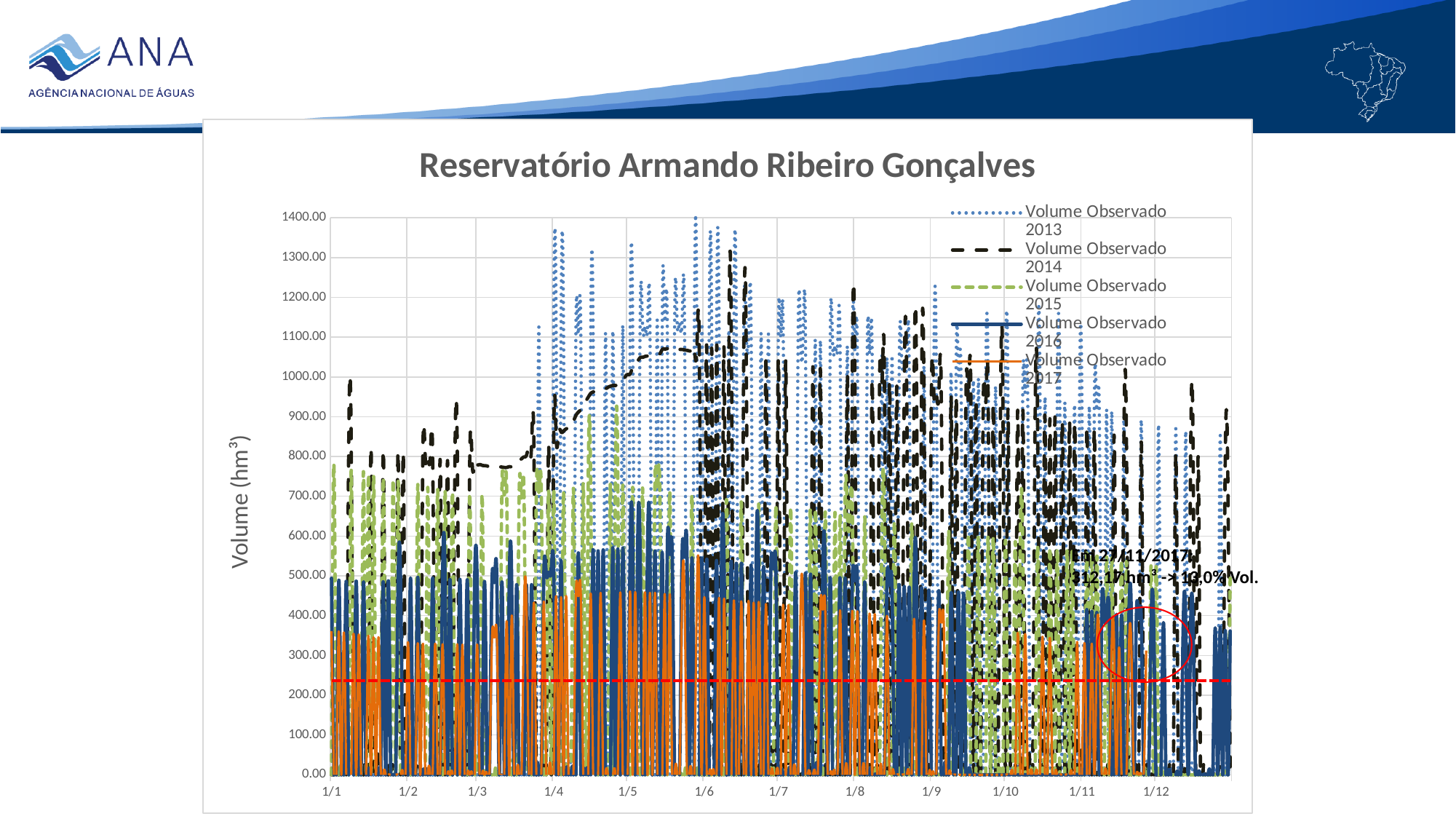
Which years are covered by the series in the legend? 2013, 2014, 2015, 2016, 2017 What is the first tick label on the horizontal axis? 1/1 What kind of chart is shown on the slide? Line chart Which series is labelled 'Volume Observado 2017' in the legend? The orange solid line What is the last tick label on the horizontal axis? 1/12 What is the highest value shown on the vertical axis? 1400.00 What is the title of the chart? Reservatório Armando Ribeiro Gonçalves What is the lowest value shown on the vertical axis? 0.00 What is the label of the vertical axis? Volume (hm³) What volume is given in the annotation for 27/11/2017? 312,17 hm³ How many tick labels are shown on the horizontal axis? 12 How many series does the legend list? 5